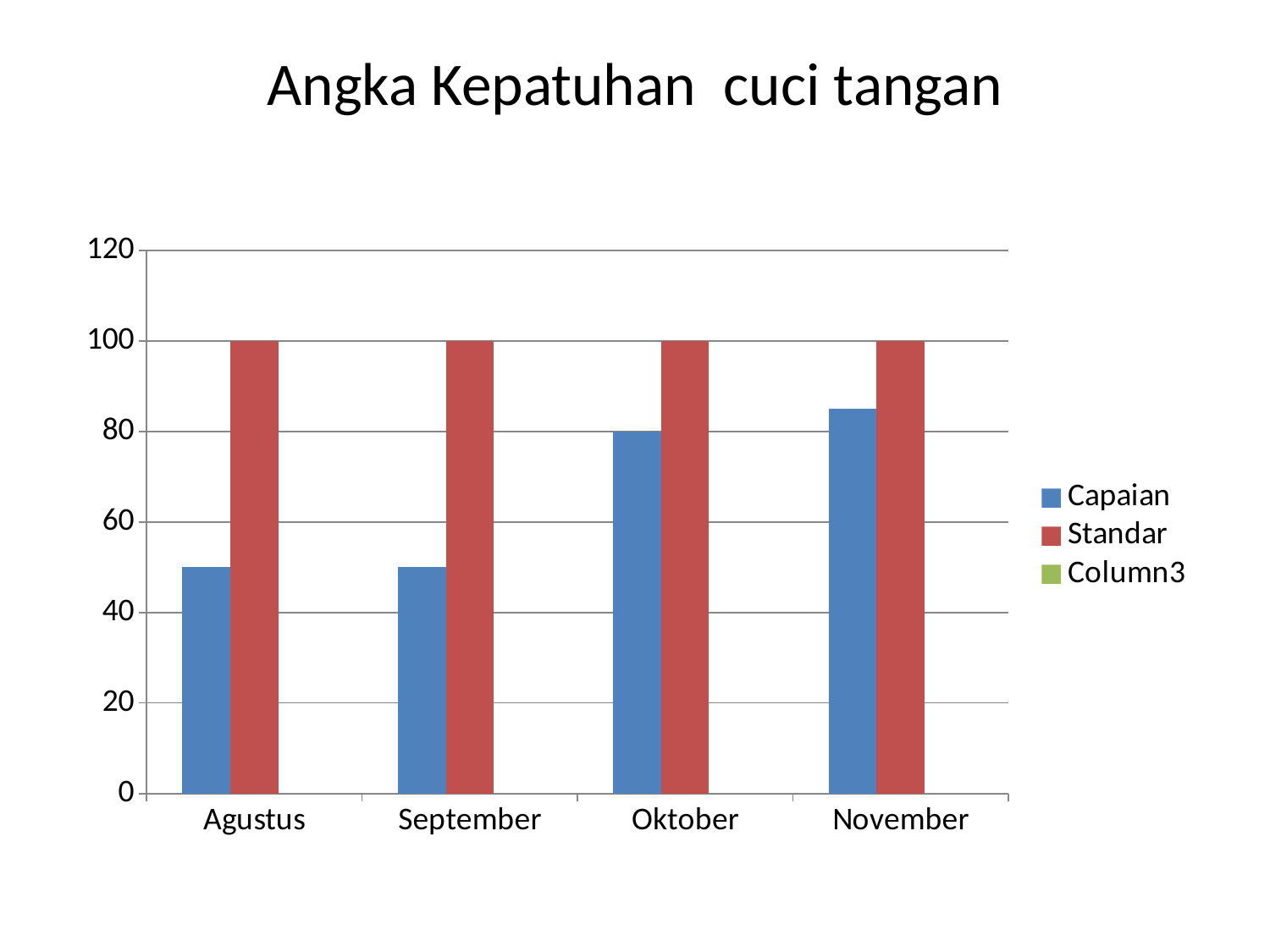
Is the Capaian value for Agustus greater or less than 60? less In September, which is larger, the Capaian value or the Standar value? Standar What is the Capaian value for Oktober? 80 What kind of chart is shown on the slide? bar chart How many series does the legend list? 3 What is the Standar value for Oktober? 100 What is the title of the chart? Angka Kepatuhan cuci tangan Which month has the highest Capaian value? November Do the Capaian values rise or fall from Agustus to November? rise What is the difference between the Standar and Capaian values for Oktober? 20 How many categories are shown on the x axis? 4 Is the Capaian value for November greater or less than 80? greater